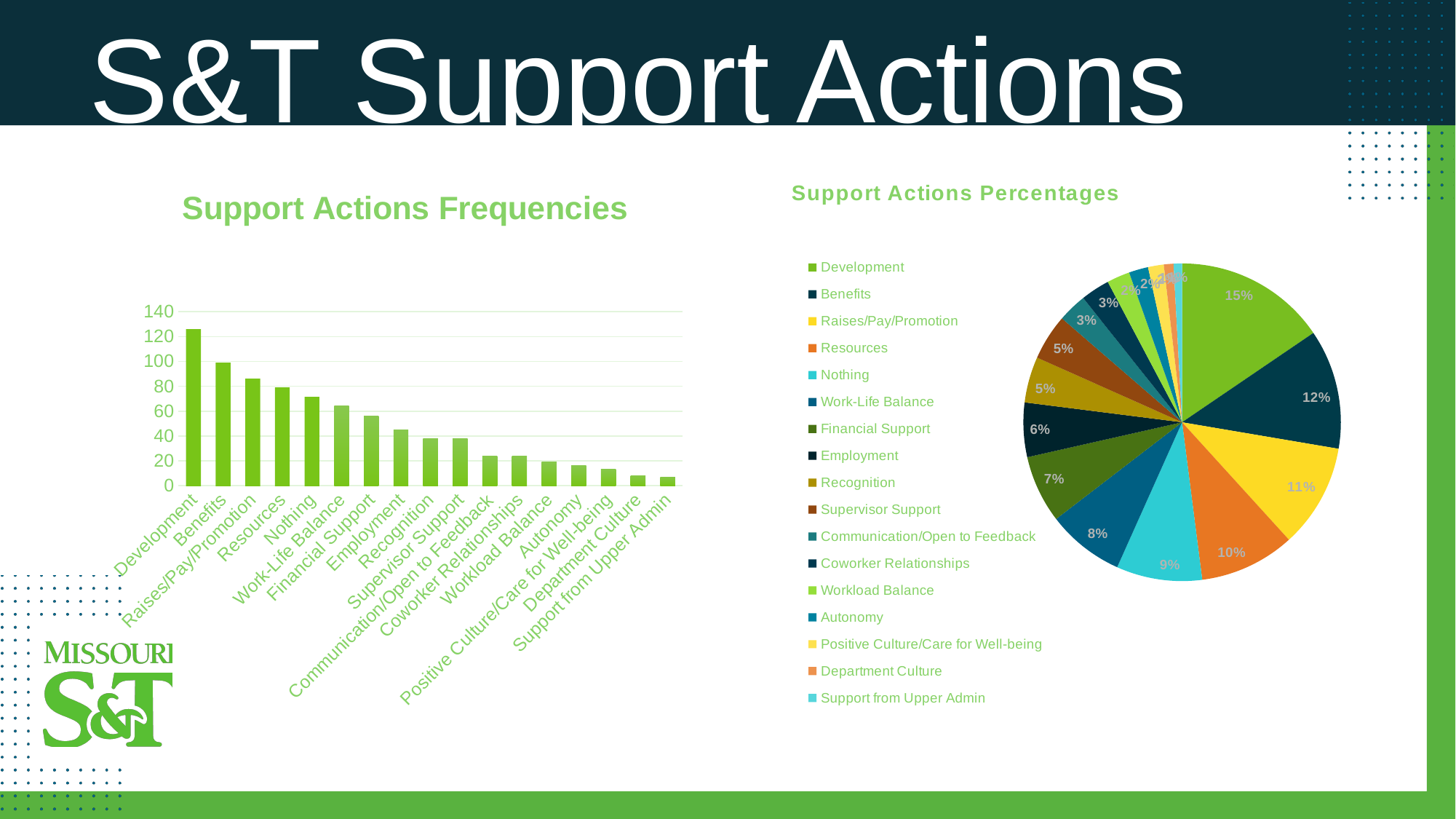
On the Support Actions Percentages pie chart, what share does Benefits have? 12% On the Support Actions Percentages pie chart, which is larger, Resources or Nothing? Resources On the Support Actions Frequencies chart, is the value for Support from Upper Admin greater or less than 20? less On the Support Actions Frequencies chart, how many categories are plotted? 17 On the Support Actions Percentages pie chart, how many entries does the legend list? 17 On the Support Actions Frequencies chart, which category has the lowest frequency? Support from Upper Admin On the Support Actions Frequencies chart, do the values rise or fall from left to right along the x axis? fall On the Support Actions Frequencies chart, what kind of chart is shown? bar chart On the Support Actions Frequencies chart, is the value for Development greater or less than 120? greater On the Support Actions Frequencies chart, which category has the highest frequency? Development On the Support Actions Frequencies chart, is the value for Nothing greater or less than 60? greater On the Support Actions Percentages pie chart, what share does Development have? 15%